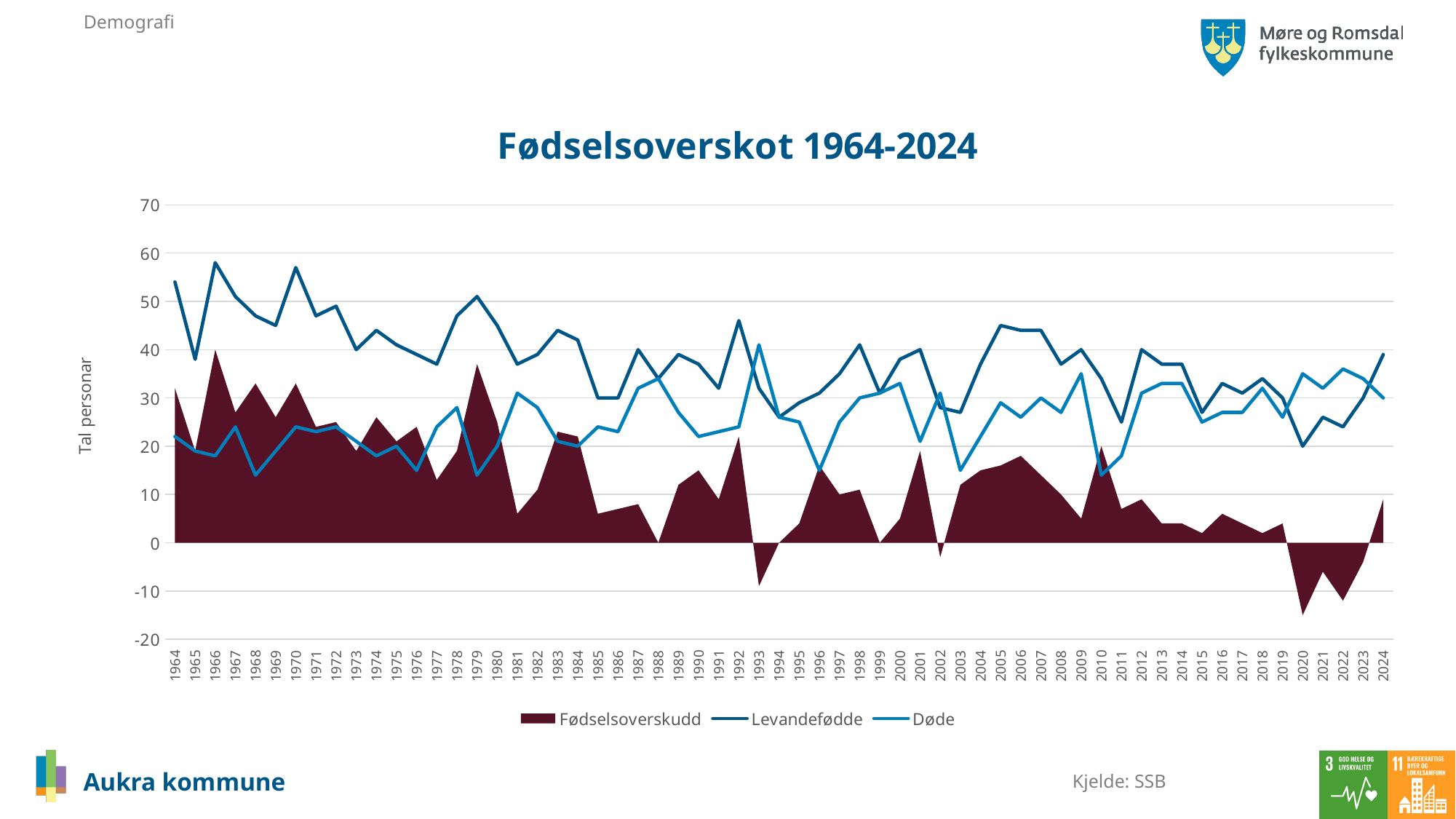
What are the three series listed in the legend? Fødselsoverskudd, Levandefødde, Døde Overall, does the Levandefødde series rise or fall from 1964 to 2024? fall Is the value for Døde in 1968 greater or less than 20? less How many series does the legend list? 3 Is the value for Levandefødde in 2020 greater or less than 30? less Which is larger: Fødselsoverskudd in 1966 or Fødselsoverskudd in 2020? 1966 Is the value for Fødselsoverskudd in 2020 greater or less than -10? less What is the title of the chart? Fødselsoverskot 1964-2024 How many years are plotted along the x axis? 61 In 1993, which is larger: Levandefødde or Døde? Døde